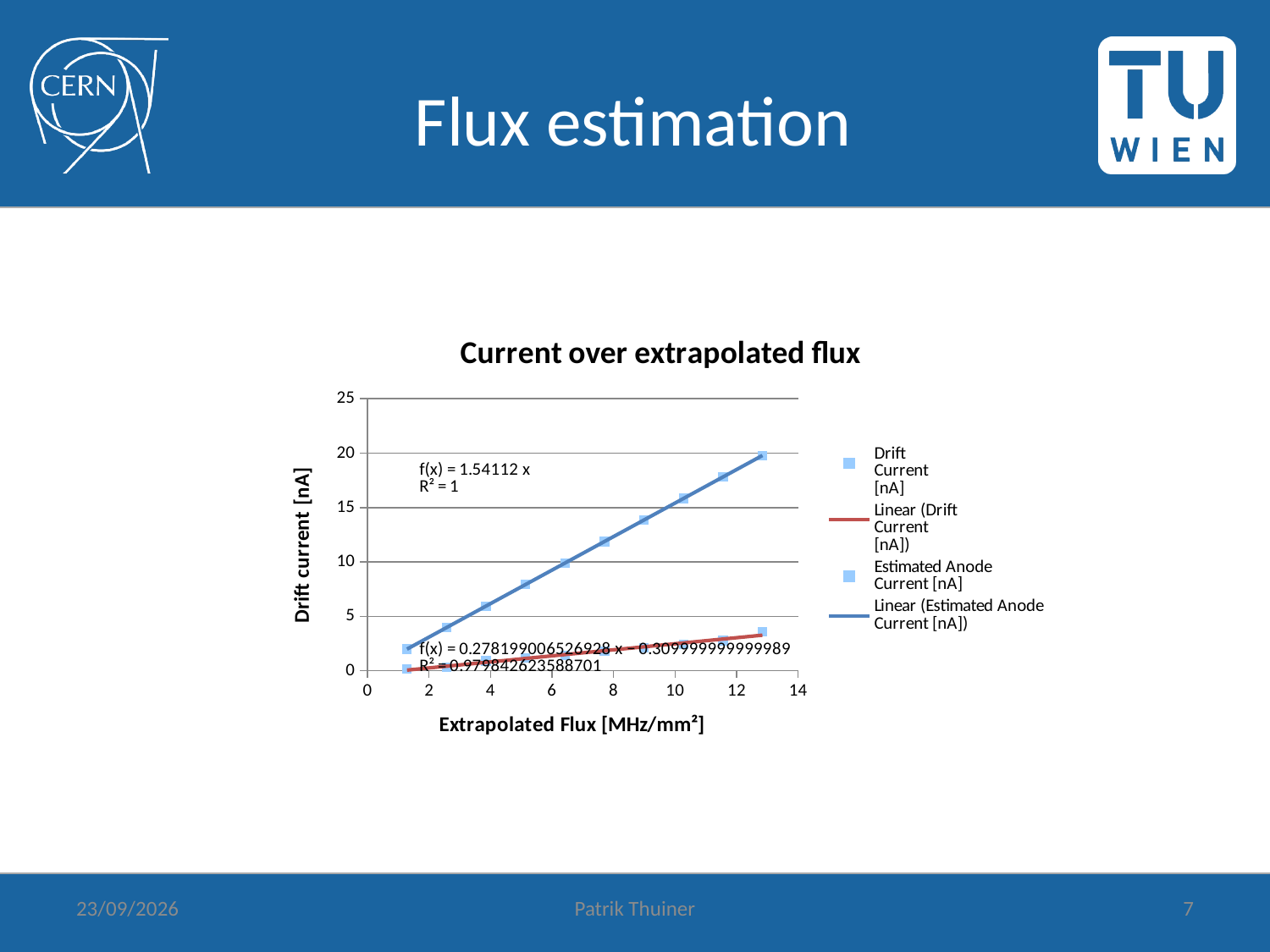
Do the Estimated Anode Current [nA] values rise or fall as the extrapolated flux increases? Rise What is the title of the chart? Current over extrapolated flux Is the highest Estimated Anode Current [nA] value greater or less than 15? greater Is the highest Drift Current [nA] value greater or less than 5? less What kind of chart is shown on the slide? Scatter chart Do the Drift Current [nA] values rise or fall as the extrapolated flux increases? Rise At an extrapolated flux of about 12.8 MHz/mm², which series has the larger value, Drift Current [nA] or Estimated Anode Current [nA]? Estimated Anode Current [nA] What is the label of the x axis? Extrapolated Flux [MHz/mm²] How many entries does the chart legend list? 4 What is the slope printed in the trendline equation f(x) = 1.54112 x? 1.54112 What is the R² value printed for the Estimated Anode Current trendline? 1